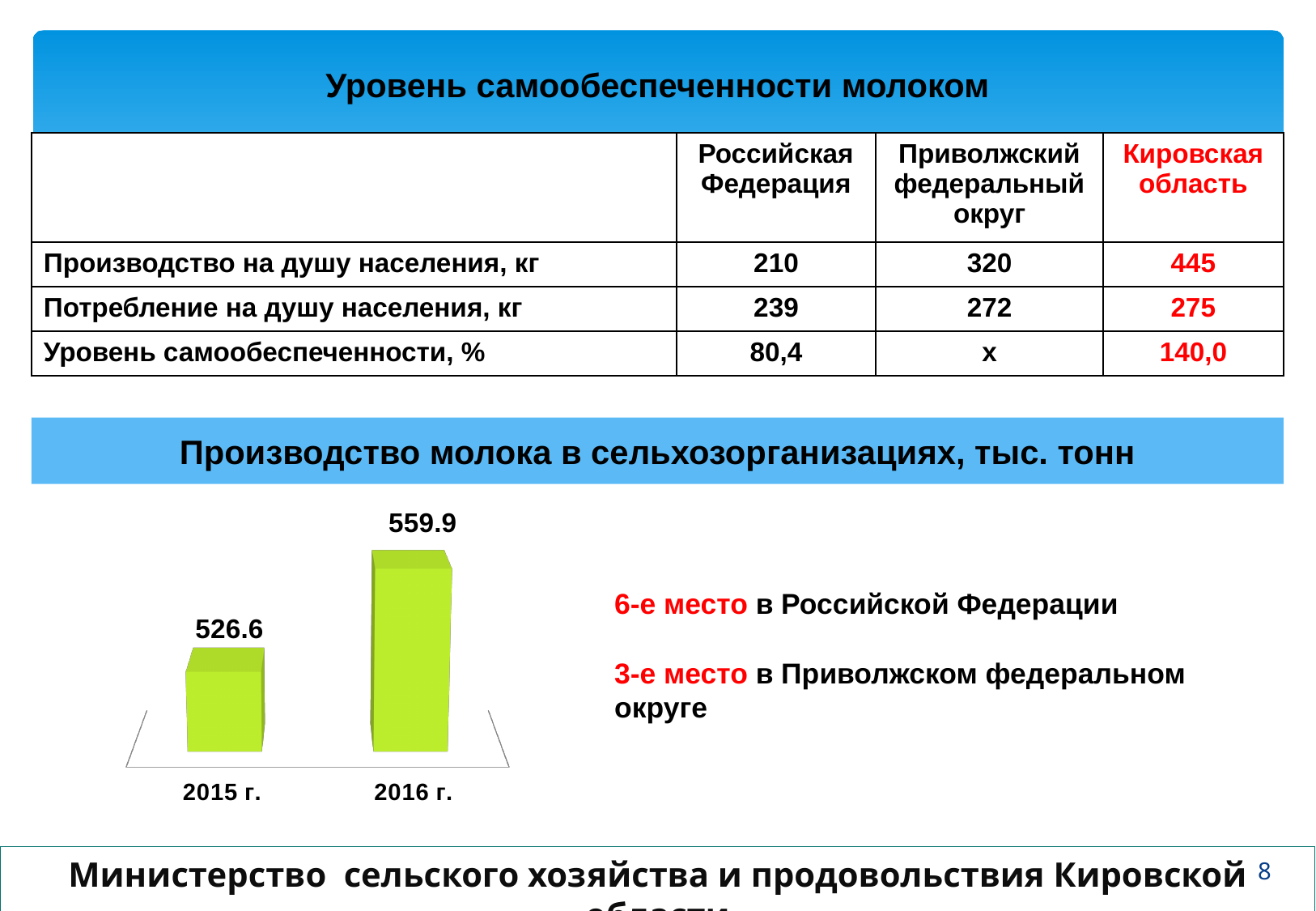
Do the values in the chart 'Производство молока в сельхозорганизациях, тыс. тонн' rise or fall from 2015 г. to 2016 г.? rise What is the title of the bar chart on the slide? Производство молока в сельхозорганизациях, тыс. тонн What is the value for 2016 г. in the chart 'Производство молока в сельхозорганизациях, тыс. тонн'? 559.9 What unit is stated in the title of the chart 'Производство молока в сельхозорганизациях, тыс. тонн'? тыс. тонн What kind of chart is 'Производство молока в сельхозорганизациях, тыс. тонн'? bar chart Which year has the highest value in the chart 'Производство молока в сельхозорганизациях, тыс. тонн'? 2016 г. What is the difference between the 2016 г. and 2015 г. values in the chart 'Производство молока в сельхозорганизациях, тыс. тонн'? 33.3 How many bars are shown in the chart 'Производство молока в сельхозорганизациях, тыс. тонн'? 2 What is the value for 2015 г. in the chart 'Производство молока в сельхозорганизациях, тыс. тонн'? 526.6 What colour are the bars in the chart 'Производство молока в сельхозорганизациях, тыс. тонн'? green In the chart 'Производство молока в сельхозорганизациях, тыс. тонн', which is larger: the value for 2015 г. or for 2016 г.? 2016 г. Which year has the lowest value in the chart 'Производство молока в сельхозорганизациях, тыс. тонн'? 2015 г.